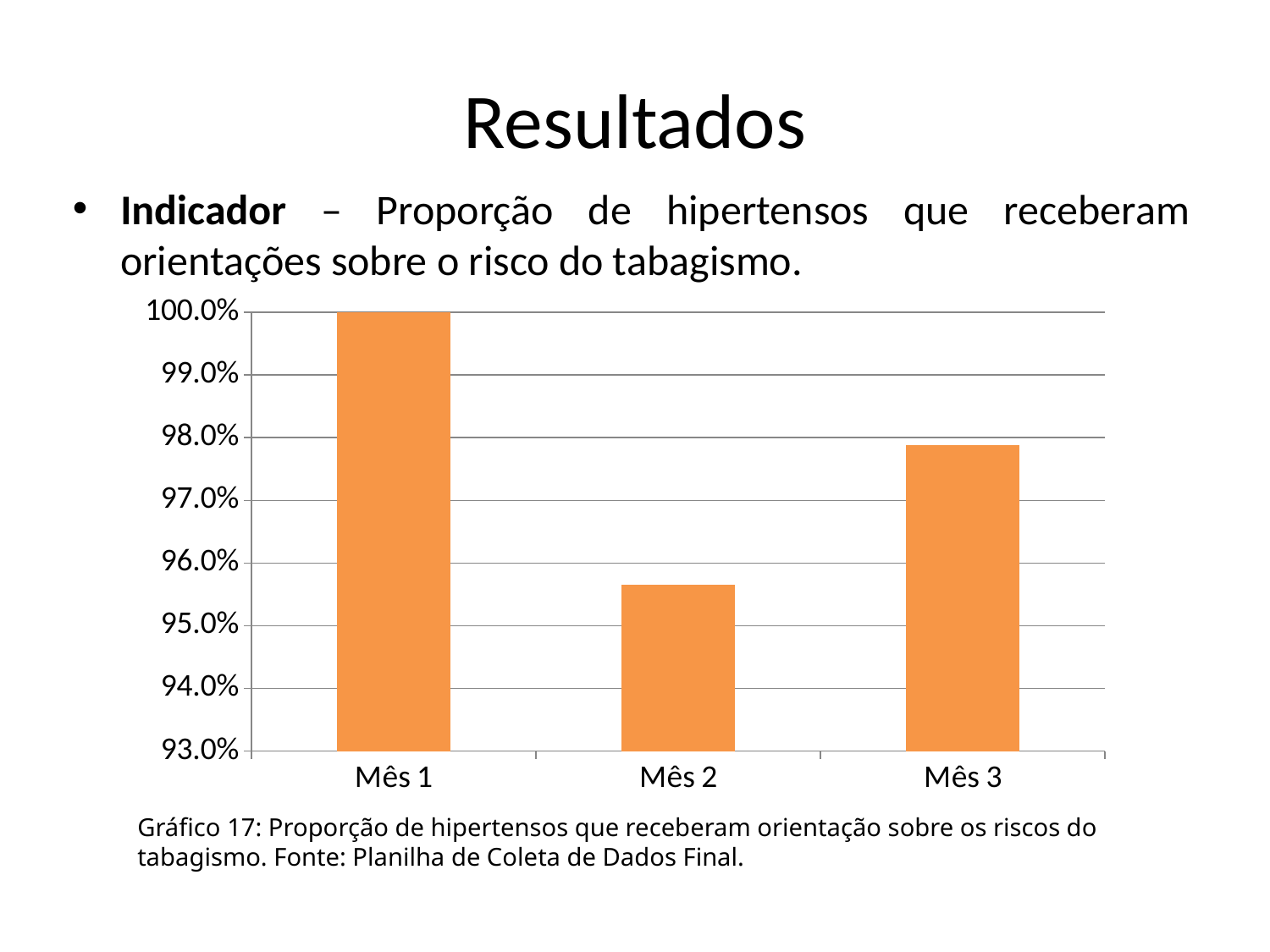
Which month has the lowest proportion in the chart? Mês 2 What is the value for Mês 1 in the chart? 100.0% What colour are the bars in the chart? orange Does the value rise or fall from Mês 1 to Mês 2? fall What type of chart is shown on the slide? bar chart Which month has the highest proportion in the chart? Mês 1 How many categories (months) are shown on the x axis of the chart? 3 Is the value for Mês 3 greater or less than 97.0%? greater Is the value for Mês 2 greater or less than 96.0%? less Is the value for Mês 3 greater or less than 98.0%? less What is the lowest value shown on the y axis of the chart? 93.0% Which is larger, the value for Mês 2 or the value for Mês 3? Mês 3